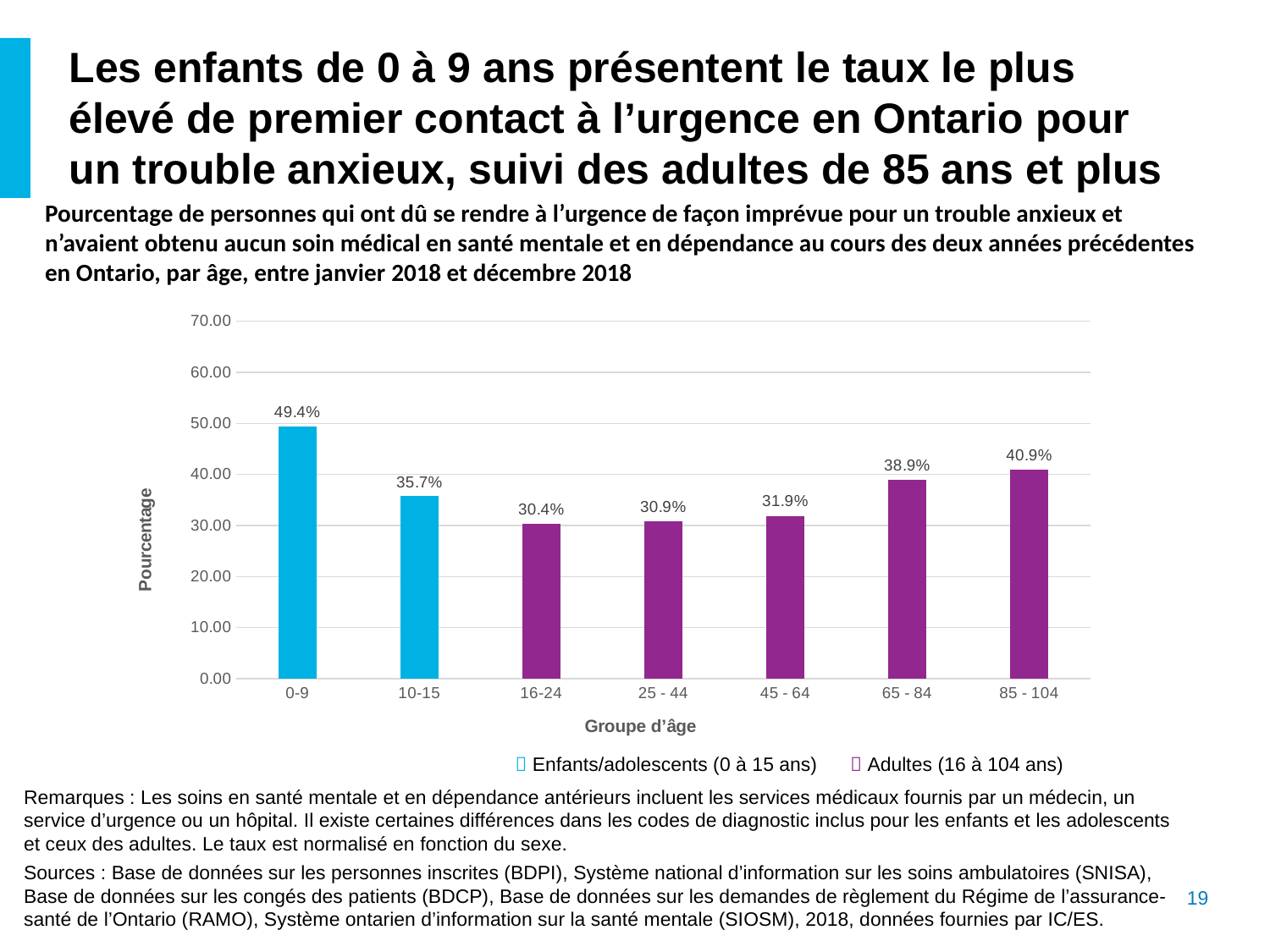
What is the value for the 45 - 64 age group? 31.9% What kind of chart is shown on the slide? bar chart Which age group has the lowest value? 16-24 Which age group has the highest value? 0-9 What is the value for the 85 - 104 age group? 40.9% What is the value for the 0-9 age group? 49.4% What is the label of the y axis? Pourcentage Is the value for the 25 - 44 age group greater or less than 40.00? less What is the difference between the values for the 0-9 and 10-15 age groups? 13.7% How many series does the legend list? 2 Which is larger, the value for 65 - 84 or the value for 85 - 104? 85 - 104 How many age groups are shown on the x axis? 7